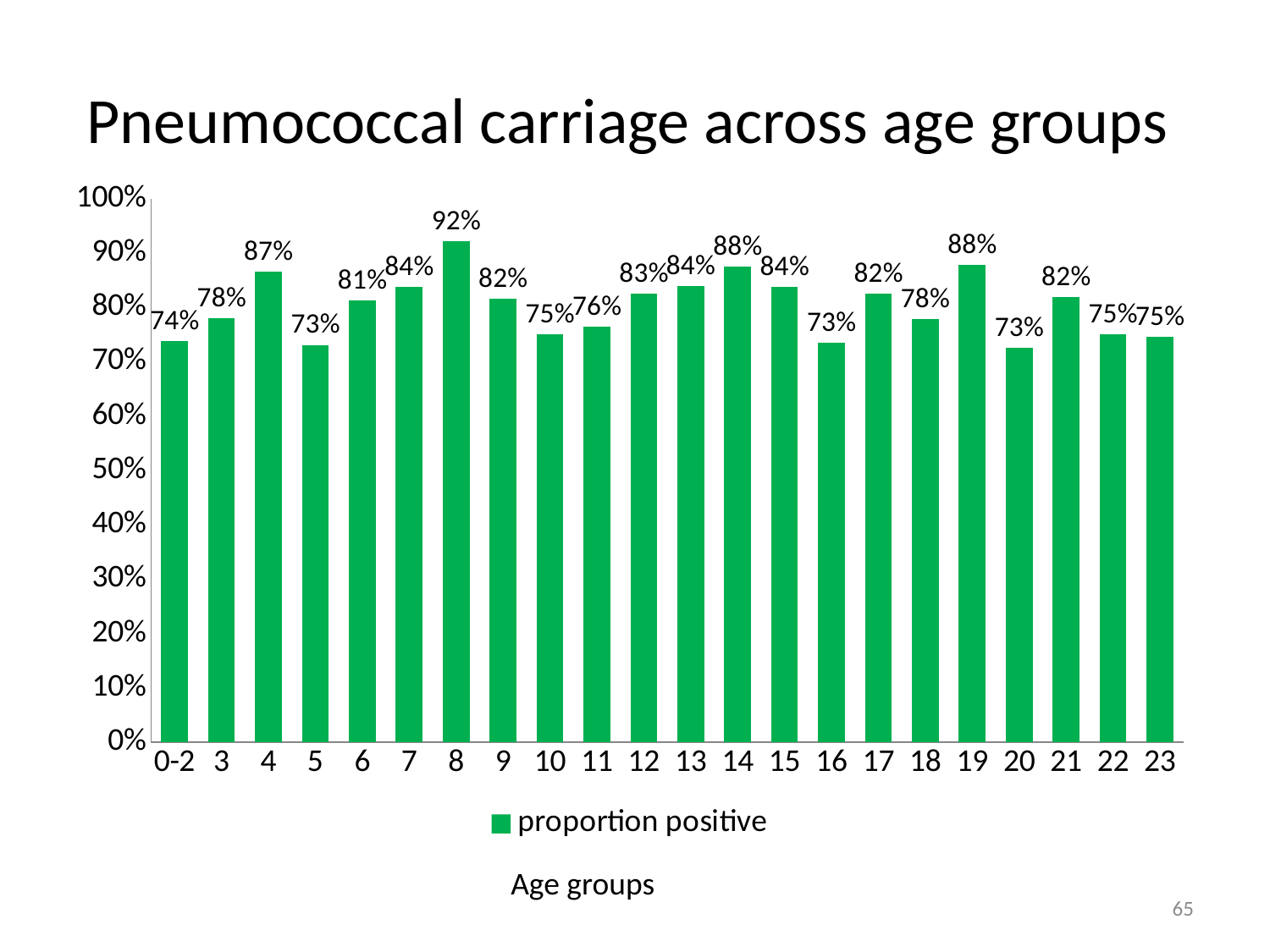
What kind of chart is shown on the slide? Bar chart How many series does the legend list? 1 Which age group has the highest proportion positive? 8 What is the proportion positive for age group 8? 92% What is the proportion positive for age group 19? 88% What is the proportion positive for age group 0-2? 74% What is the difference between the proportion positive for age group 8 and age group 5? 19% How many age groups are shown on the chart? 22 What is the title of the chart? Pneumococcal carriage across age groups What is the lowest proportion positive shown on the chart? 73% Which has a higher proportion positive, age group 4 or age group 10? Age group 4 Is the proportion positive for age group 14 greater or less than 80%? greater